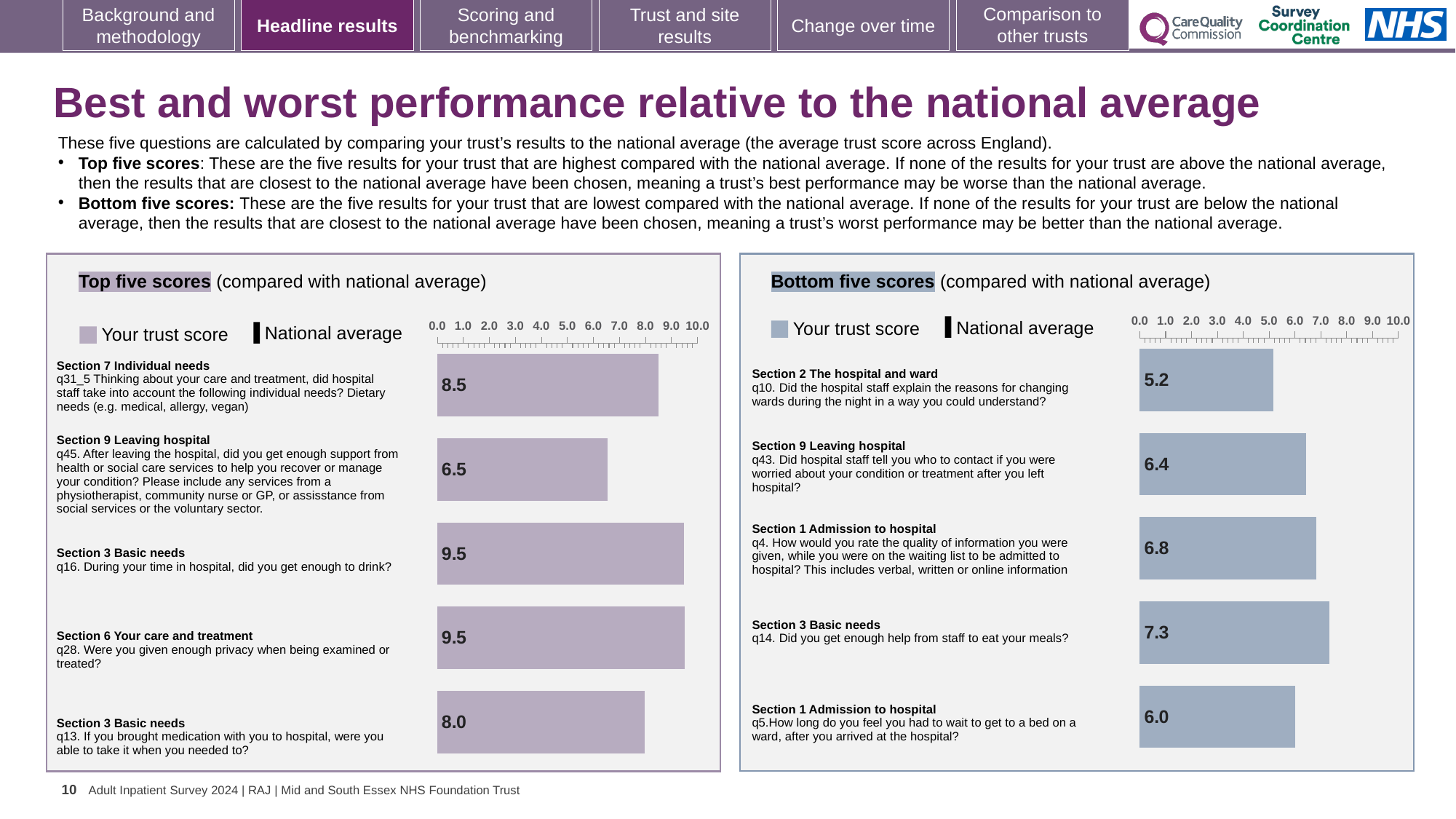
In the Bottom five scores chart, which question has the highest trust score? q14 (Section 3 Basic needs) In the Bottom five scores chart, which has the larger trust score, q43 or q5? q43 In the Bottom five scores chart, which question has the lowest trust score? q10 (Section 2 The hospital and ward) In the Bottom five scores chart, what is the trust score for q10 (Did the hospital staff explain the reasons for changing wards during the night in a way you could understand?)? 5.2 In the Bottom five scores chart, what is the trust score for q14 (Did you get enough help from staff to eat your meals?)? 7.3 In the Top five scores chart, which question has the lowest trust score? q45 (Section 9 Leaving hospital) In the Top five scores chart, what is the trust score for q16 (During your time in hospital, did you get enough to drink?)? 9.5 In the Bottom five scores chart, what is the difference between the trust scores for q14 and q10? 2.1 What type of chart is the Top five scores chart? Bar chart In the Top five scores chart, what is the trust score for q13 (If you brought medication with you to hospital, were you able to take it when you needed to?)? 8.0 In the Top five scores chart, what is the difference between the trust scores for q31_5 and q45? 2.0 How many questions are shown in the Bottom five scores chart? 5